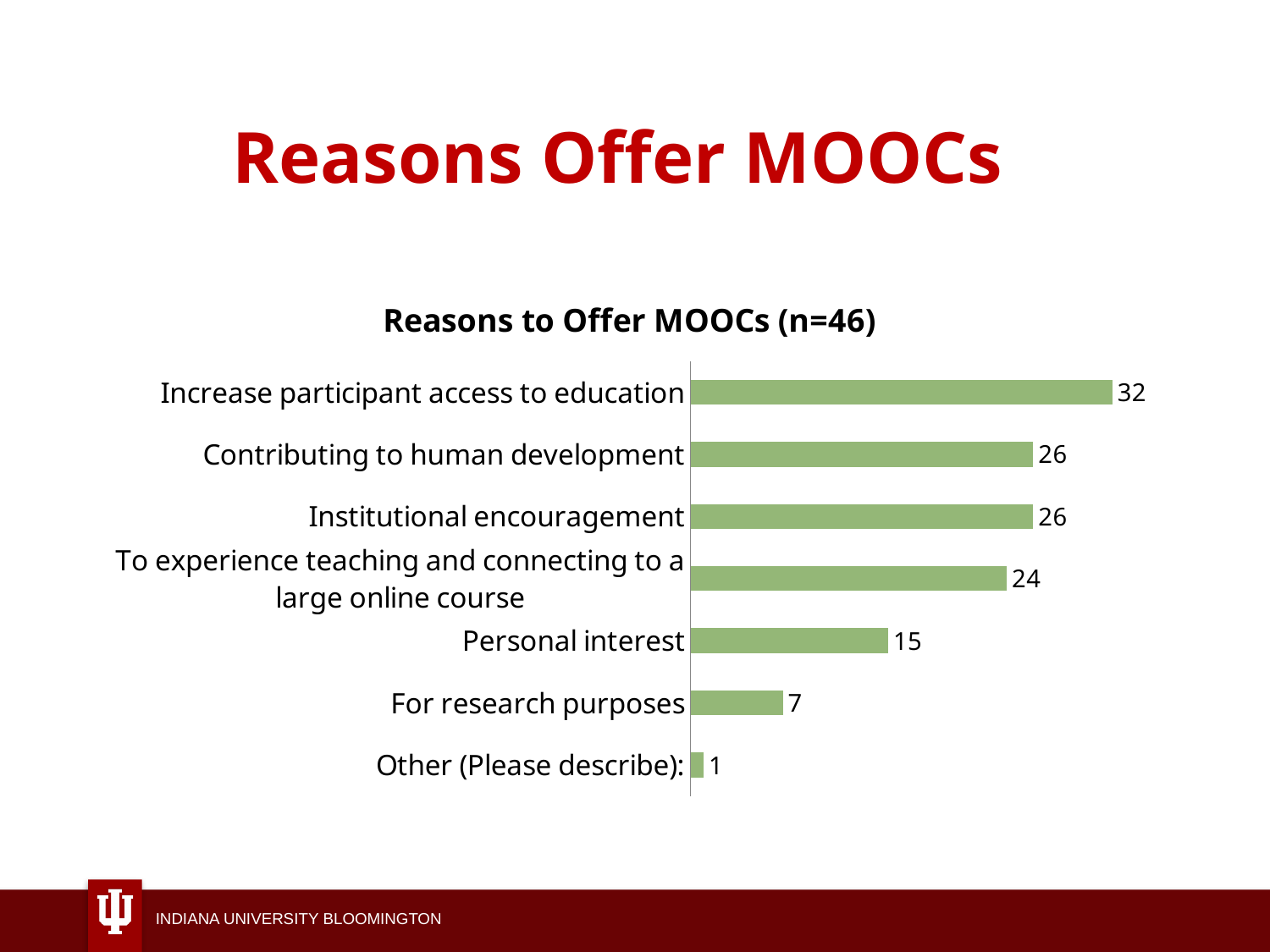
What is the title of the chart? Reasons to Offer MOOCs (n=46) What kind of chart is shown on the slide? Bar chart What is the value for "To experience teaching and connecting to a large online course"? 24 Which reason has the lowest value? Other (Please describe): What is the difference between the values for "Increase participant access to education" and "Contributing to human development"? 6 Which reason has the highest value? Increase participant access to education How many reasons (categories) are shown in the chart? 7 What is the value for "Personal interest"? 15 What is the difference between the values for "Personal interest" and "For research purposes"? 8 What is the value for "For research purposes"? 7 What is the value for "Increase participant access to education"? 32 Which is larger, the value for "Institutional encouragement" or the value for "Personal interest"? Institutional encouragement